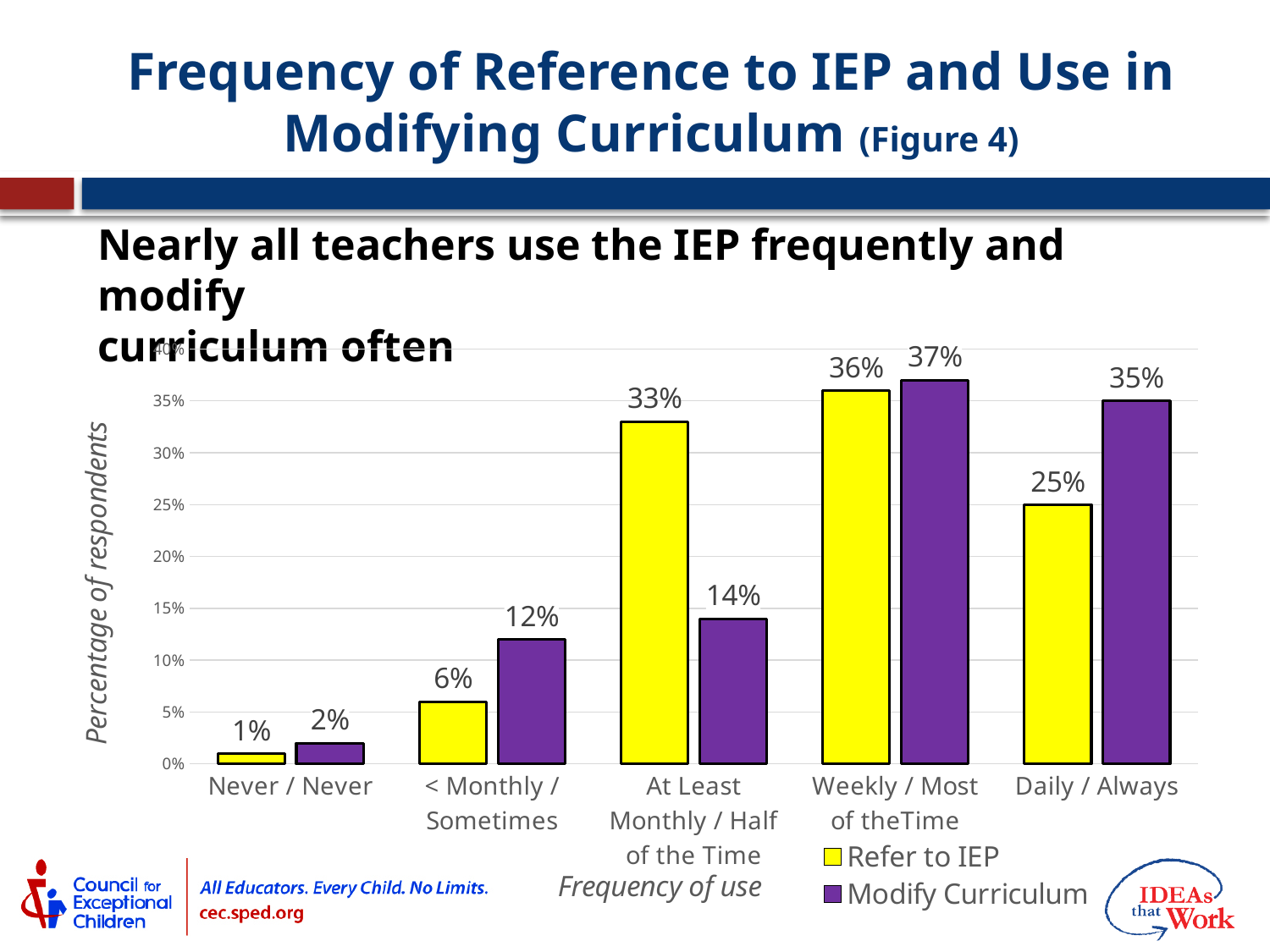
What is the label of the y axis? Percentage of respondents Which category has the lowest value for Refer to IEP? Never / Never What kind of chart is shown on the slide? Bar chart How many series does the legend list? 2 What percentage of respondents refer to the IEP at least monthly / half of the time? 33% Which category has the highest value for Modify Curriculum? Weekly / Most of the Time Which colour represents the Refer to IEP series? Yellow What is the value for Modify Curriculum in the Daily / Always category? 35% What is the value for Refer to IEP in the < Monthly / Sometimes category? 6% In the Daily / Always category, which series has the larger value, Refer to IEP or Modify Curriculum? Modify Curriculum What is the difference between Refer to IEP and Modify Curriculum in the At Least Monthly / Half of the Time category? 19% How many frequency categories are shown on the x axis? 5